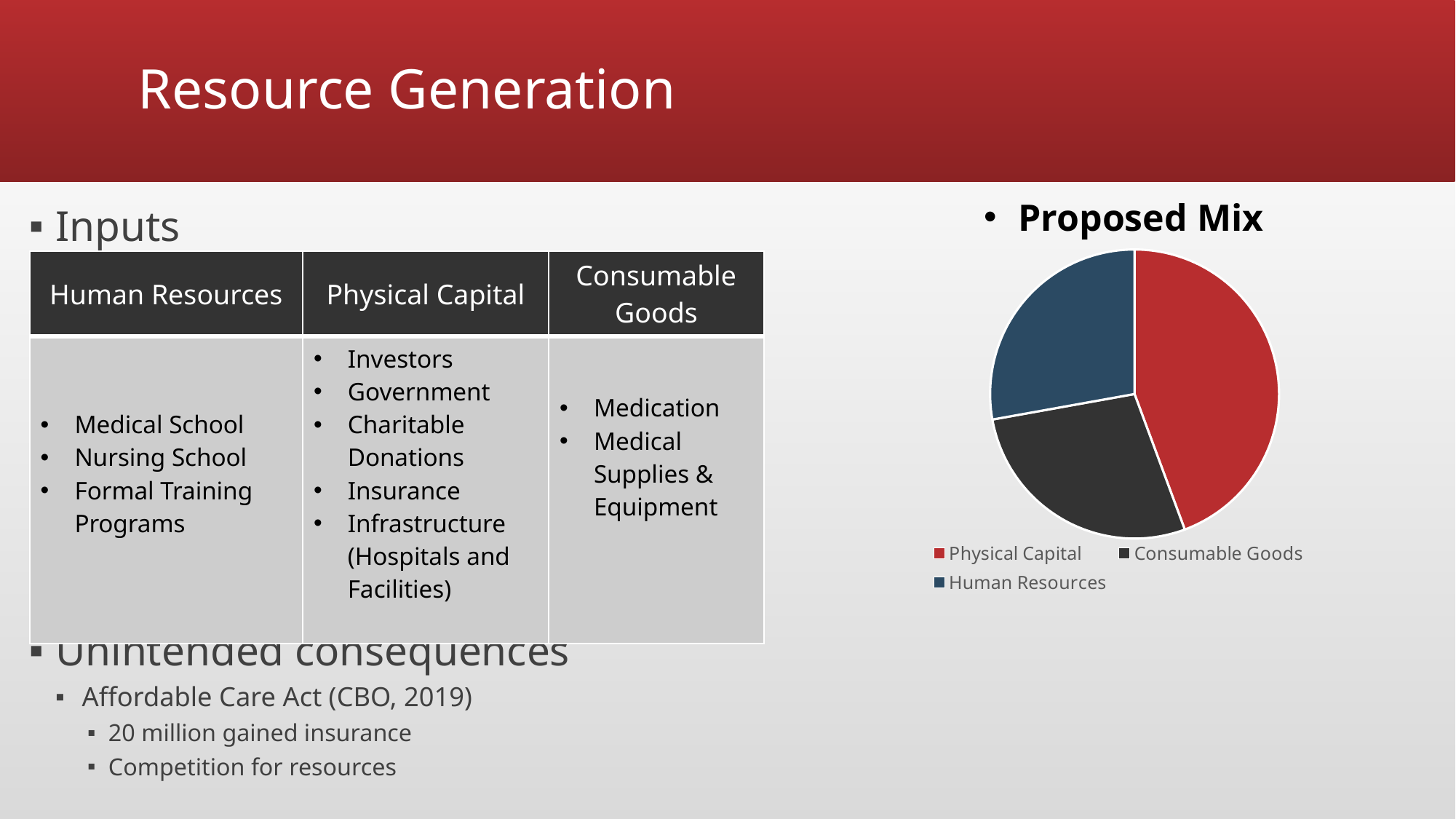
How many entries does the legend of the "Proposed Mix" pie chart list? 3 Which category has the largest slice in the "Proposed Mix" pie chart? Physical Capital Which category is shown in red in the "Proposed Mix" pie chart? Physical Capital What kind of chart is shown under the heading "Proposed Mix"? pie chart In the "Proposed Mix" pie chart, which slice is larger: Human Resources or Physical Capital? Physical Capital What is the title of the pie chart on the slide? Proposed Mix How many slices does the "Proposed Mix" pie chart have? 3 In the "Proposed Mix" pie chart, which slice is larger: Physical Capital or Consumable Goods? Physical Capital